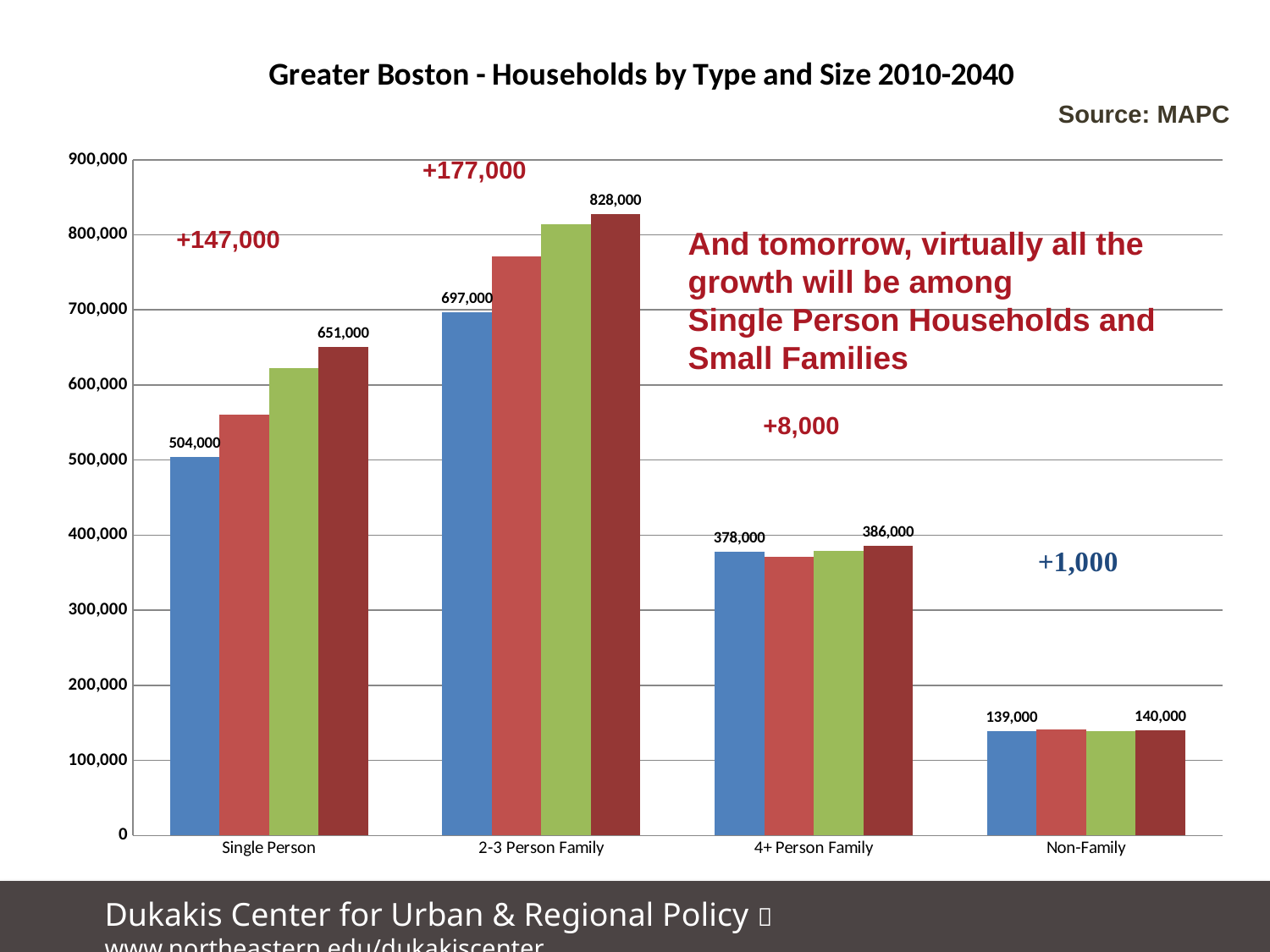
What is the value of the last (dark red) bar for 4+ Person Family households? 386,000 Which is larger: the first (blue) bar for 2-3 Person Family or the last (dark red) bar for Single Person? 2-3 Person Family first bar (697,000) What is the value of the last (dark red) bar for 2-3 Person Family households? 828,000 What is the difference between the last (dark red) bar and the first (blue) bar for Single Person households? 147,000 What type of chart is shown on the slide? bar chart What is the value of the first (blue) bar for Non-Family households? 139,000 What is the value of the first (blue) bar for Single Person households? 504,000 What growth figure is annotated above the 4+ Person Family bars? +8,000 How many household categories are shown on the x axis? 4 Which household category has the highest bars? 2-3 Person Family Which household category has the lowest bars? Non-Family Is the value of the second (red) bar for Single Person households greater or less than 500,000? greater